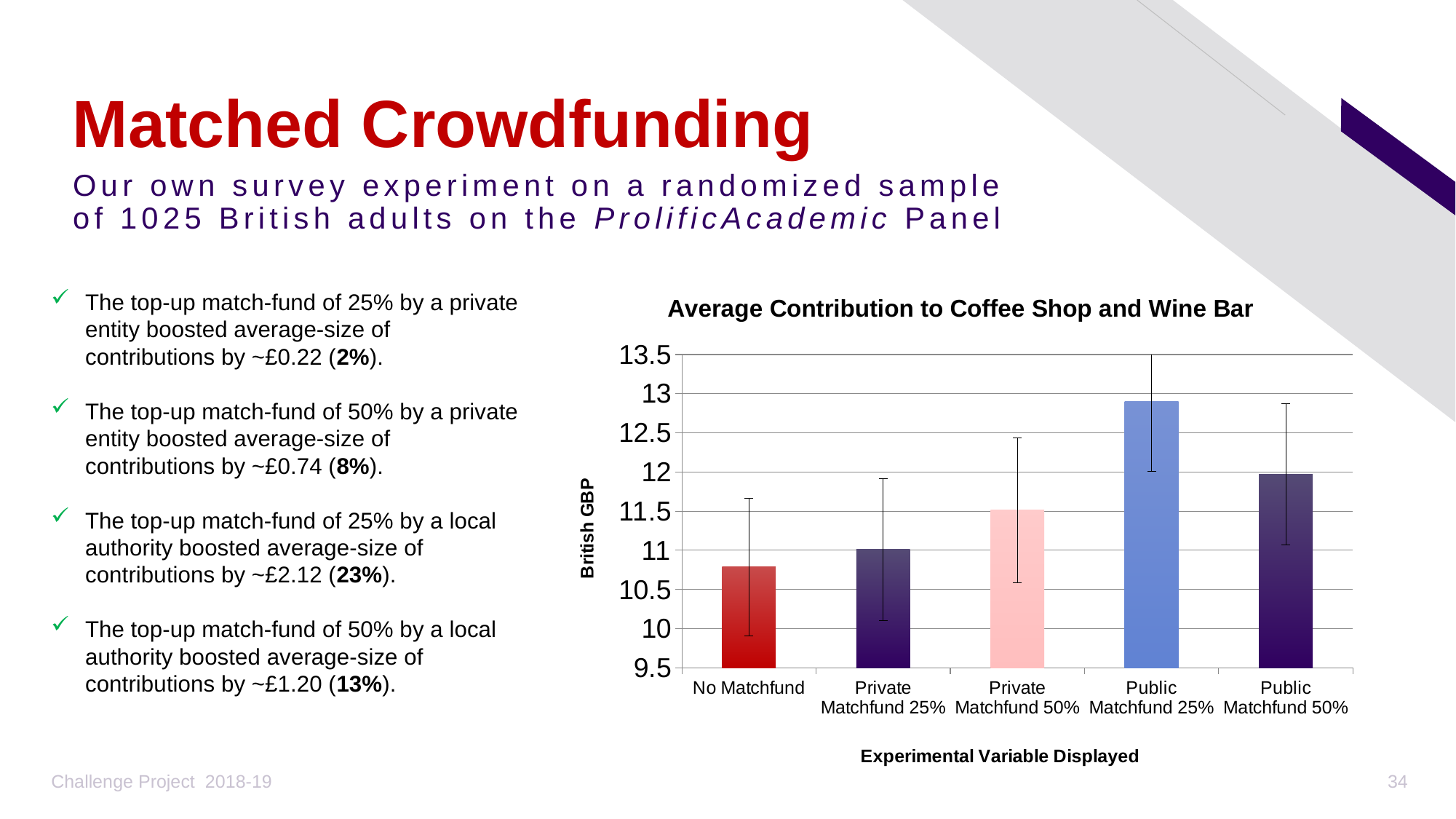
Is the value for Private Matchfund 50% greater or less than 11? greater What is the title of the chart? Average Contribution to Coffee Shop and Wine Bar Which category has the lowest average contribution? No Matchfund How many categories are shown on the x axis of the chart? 5 Is the value for Public Matchfund 50% greater or less than 12.5? less Which is larger, the value for Private Matchfund 25% or Private Matchfund 50%? Private Matchfund 50% Is the value for Public Matchfund 25% greater or less than 12.5? greater What is the label of the vertical axis of the chart? British GBP Which category has the highest average contribution? Public Matchfund 25% Which is larger, the value for Public Matchfund 25% or Public Matchfund 50%? Public Matchfund 25% What type of chart is shown on the slide? Bar chart